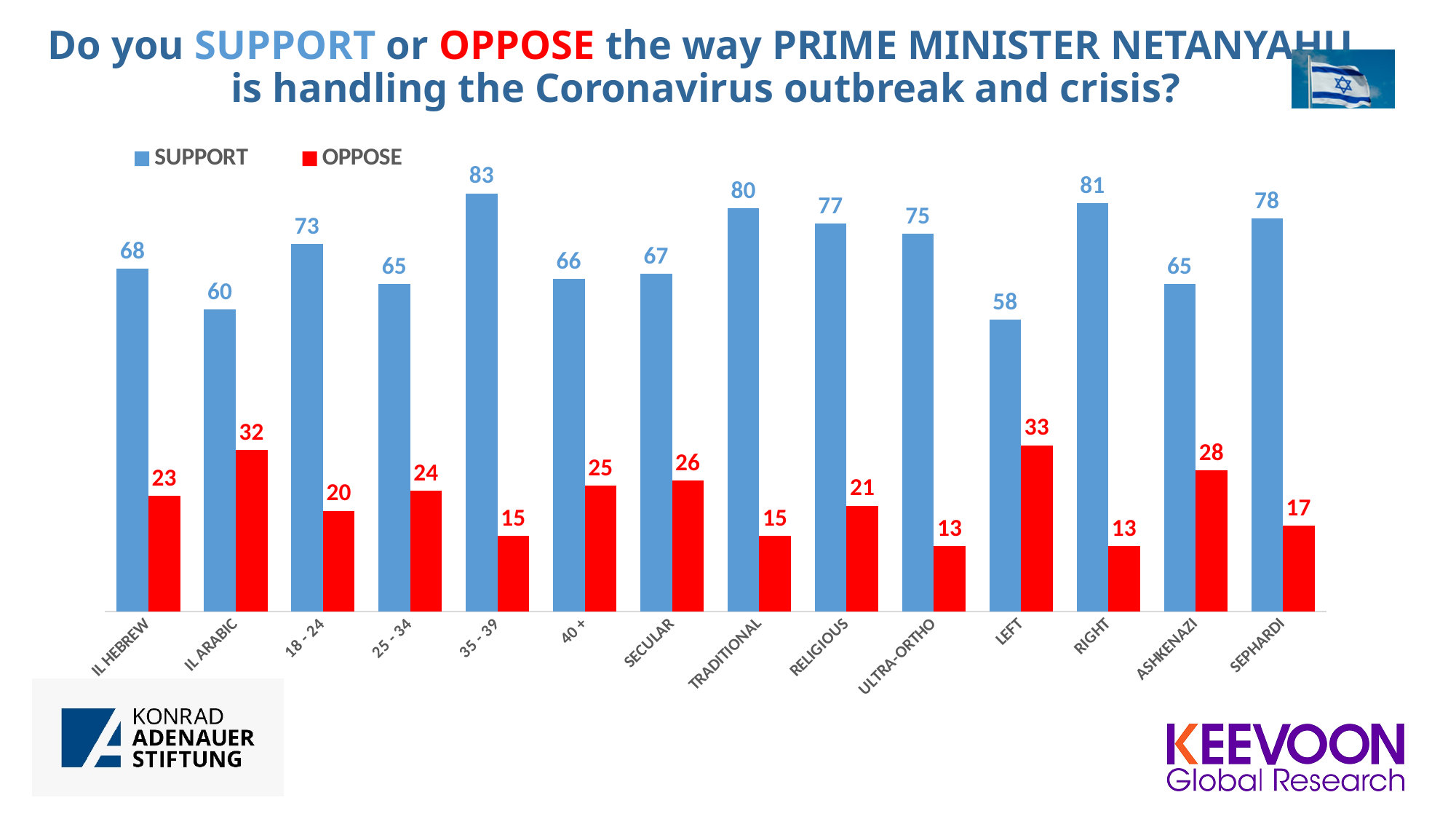
What is the OPPOSE value for LEFT? 33 What is the difference between the SUPPORT and OPPOSE values for RIGHT? 68 What kind of chart is shown on the slide? Bar chart How many series does the legend list? 2 How many categories are shown on the x axis? 14 What is the SUPPORT value for IL ARABIC? 60 Which category has the highest SUPPORT value? 35 - 39 Which category has the highest OPPOSE value? LEFT Which category has the lowest SUPPORT value? LEFT What is the SUPPORT value for ULTRA-ORTHO? 75 What colour are the OPPOSE bars? Red Which is larger, the OPPOSE value for IL ARABIC or the OPPOSE value for ASHKENAZI? IL ARABIC